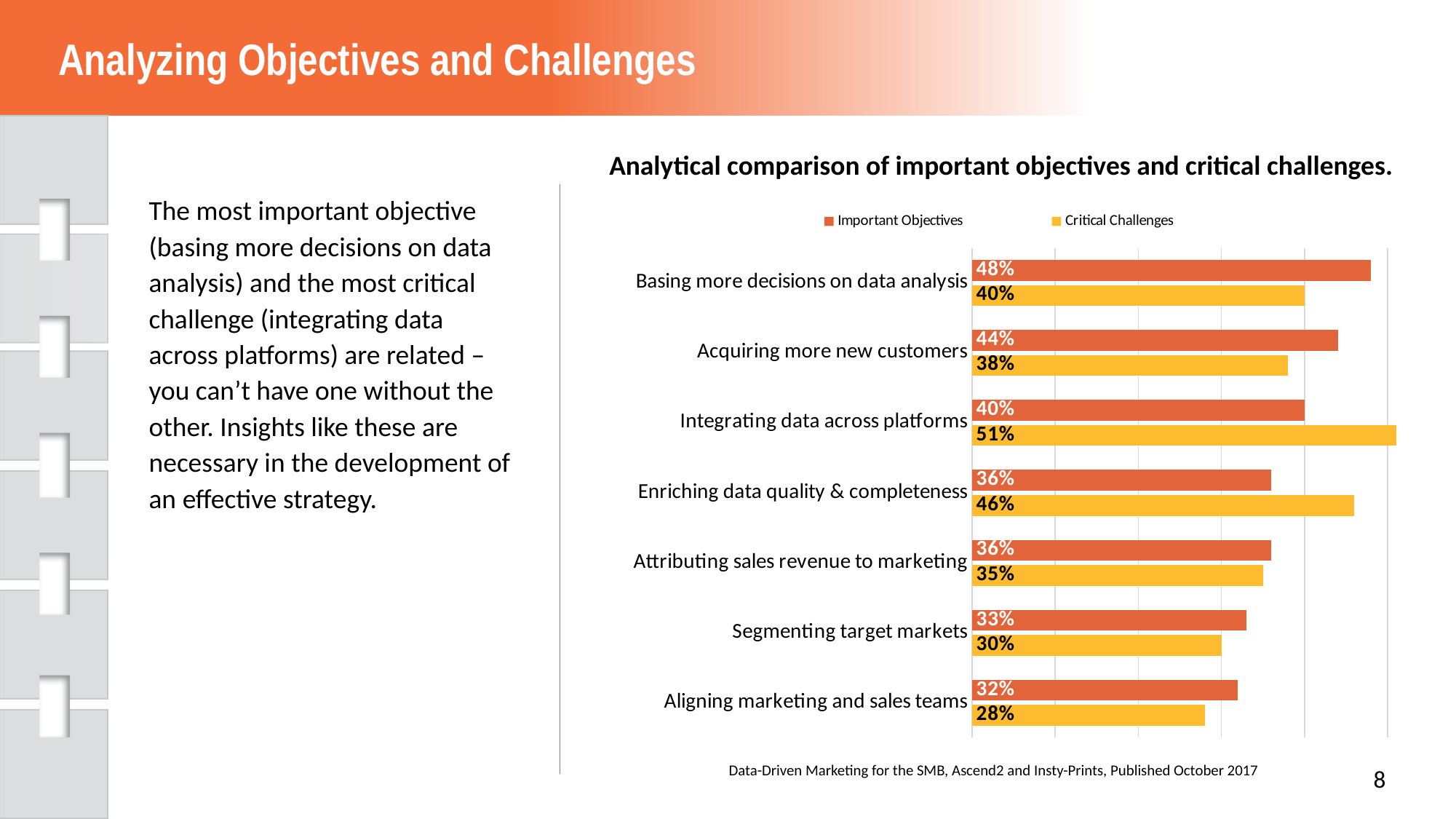
How many series does the legend list? 2 How many categories are shown in the chart? 7 What is the title of the chart? Analytical comparison of important objectives and critical challenges. For Enriching data quality & completeness, which is larger: Important Objectives or Critical Challenges? Critical Challenges Which category has the lowest Important Objectives value? Aligning marketing and sales teams Which category has the highest Critical Challenges value? Integrating data across platforms What is the Important Objectives value for Basing more decisions on data analysis? 48% What is the difference between the Critical Challenges and Important Objectives values for Integrating data across platforms? 11% What is the Critical Challenges value for Aligning marketing and sales teams? 28% What kind of chart is shown on the slide? Bar chart What is the difference between the Important Objectives and Critical Challenges values for Basing more decisions on data analysis? 8% What is the Critical Challenges value for Integrating data across platforms? 51%